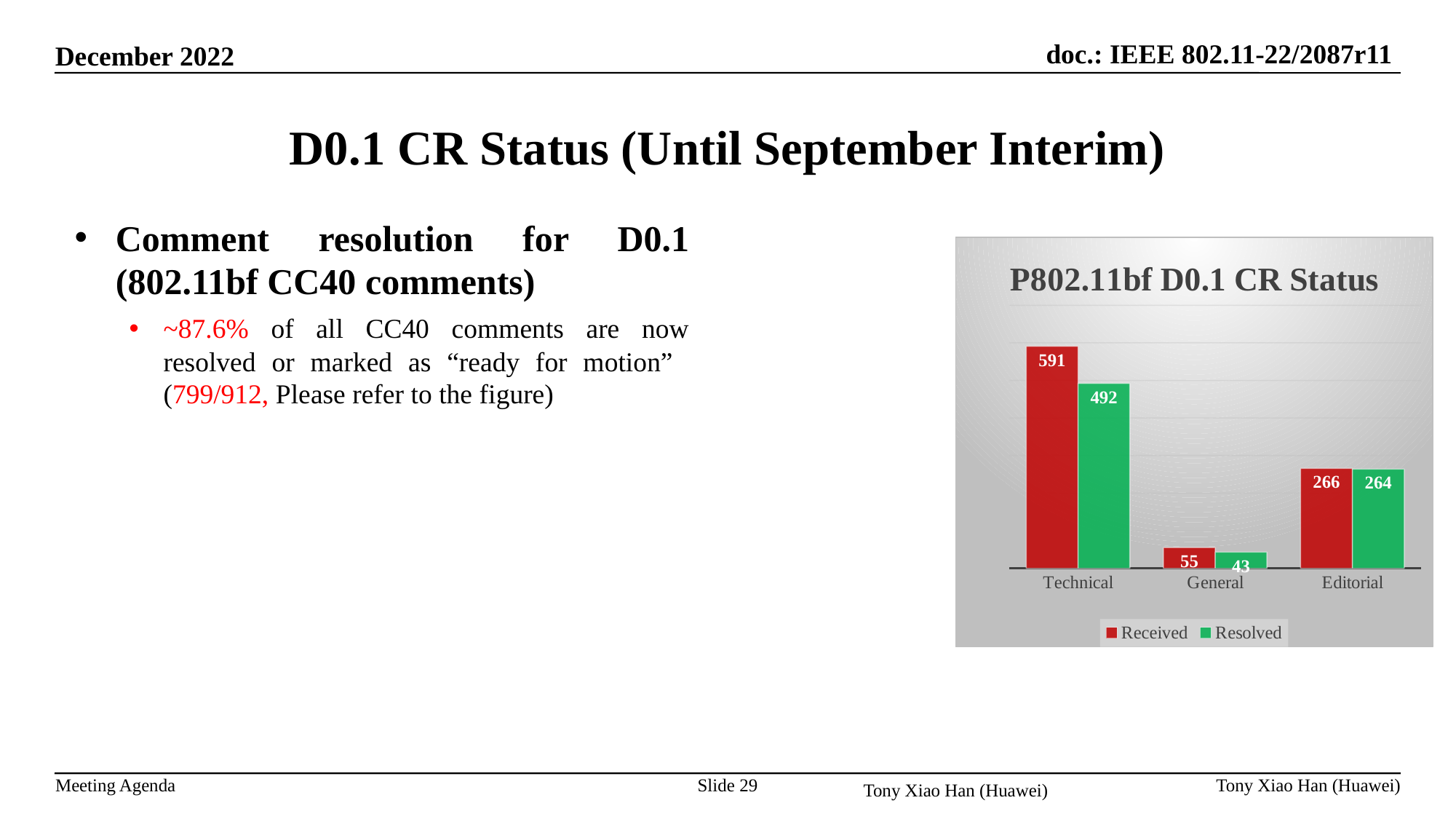
What is the difference between Received and Resolved for General? 12 Which category has the highest Received value? Technical What is the difference between Received and Resolved for Technical? 99 What kind of chart is shown on the slide? Bar chart What is the title of the chart? P802.11bf D0.1 CR Status Which is larger, the Received value for Editorial or the Resolved value for Technical? Resolved value for Technical What is the Resolved value for General? 43 How many series does the legend list? 2 What is the Resolved value for Editorial? 264 Which category has the lowest Resolved value? General What is the Received value for Technical? 591 How many categories are shown on the x axis? 3